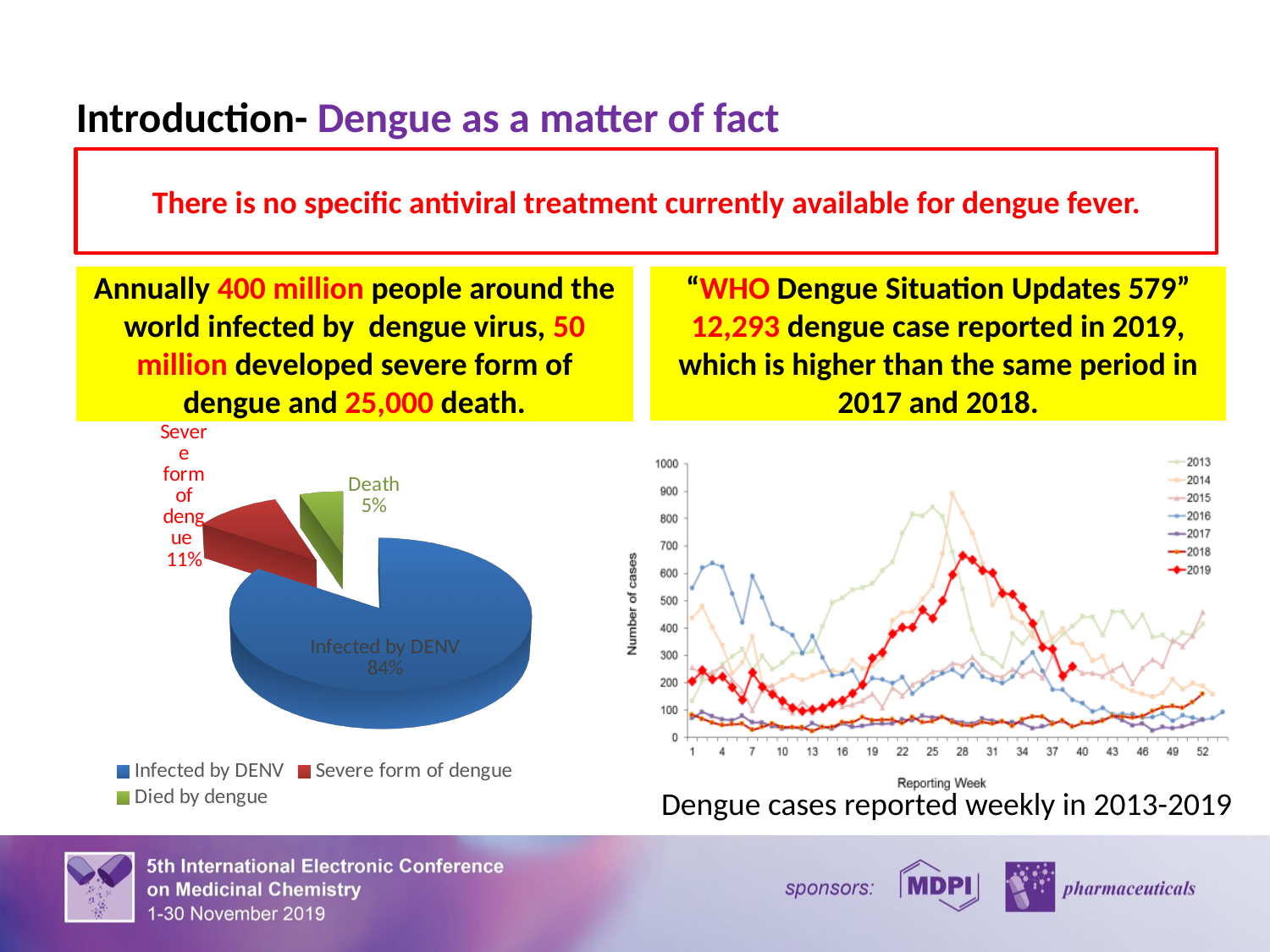
In the chart 'Dengue cases reported weekly in 2013-2019', what is the label of the y axis? Number of cases In the pie chart on the left, which category has the smallest share? Death (Died by dengue) In the pie chart on the left, what percentage is shown for Severe form of dengue? 11% In the pie chart on the left, how many slices are there? 3 In the pie chart on the left, what percentage is shown for the Death slice? 5% In the pie chart on the left, what percentage is shown for Infected by DENV? 84% What kind of chart is the chart on the left of the slide? Pie chart What kind of chart is 'Dengue cases reported weekly in 2013-2019'? Line chart In the chart titled 'Dengue cases reported weekly in 2013-2019', how many series does the legend list? 7 In the chart 'Dengue cases reported weekly in 2013-2019', is the peak value of the 2019 series greater or less than 500? greater In the pie chart on the left, what is the difference in percentage points between Infected by DENV and Severe form of dengue? 73 In the pie chart on the left, which category has the largest share? Infected by DENV